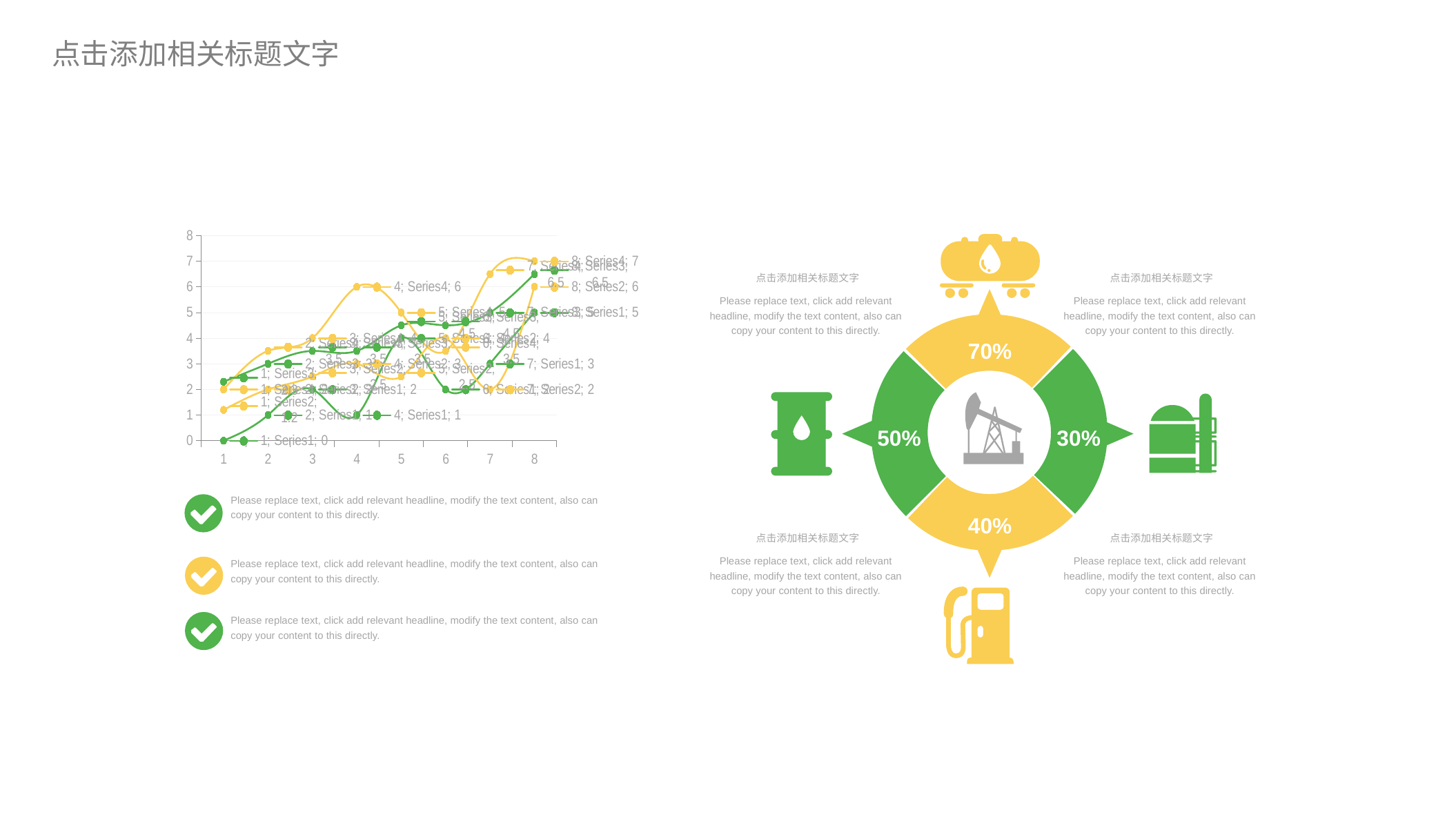
In the line chart, what is the value of Series1 at x = 8? 5 In the line chart, what is the value of Series1 at x = 1? 0 In the line chart, what is the value of Series2 at x = 8? 6 In the line chart, how many points are marked along the x axis? 8 In the line chart, what is the value of Series4 at x = 8? 7 In the line chart, what is the value of Series1 at x = 4? 1 In the line chart, what is the highest value shown on the y axis? 8 In the line chart, which is larger at x = 8: Series4 or Series1? Series4 What kind of chart is shown on the left of the slide? line chart In the line chart, what is the value of Series1 at x = 7? 3 In the line chart, what is the value of Series4 at x = 4? 6 In the line chart, what is the difference between Series4 and Series1 at x = 8? 2